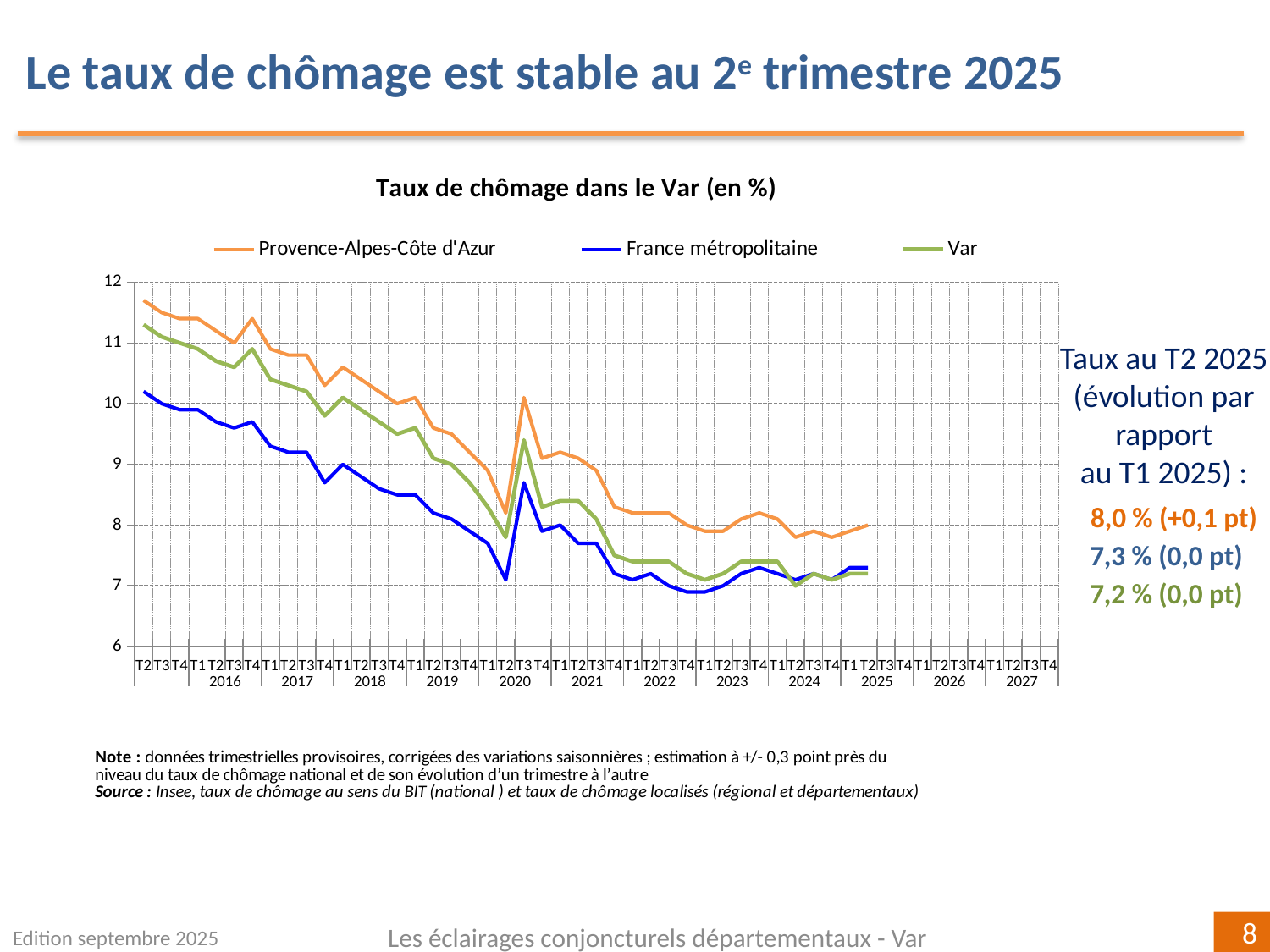
What is the unemployment rate for Provence-Alpes-Côte d'Azur at T2 2025? 8,0 % What is the title of the chart? Taux de chômage dans le Var (en %) Overall, does the Var line rise or fall between 2016 and 2025? fall What kind of chart is shown on the slide? line chart Is the value for France métropolitaine at T2 2020 greater or less than 8? less What is the unemployment rate for France métropolitaine at T2 2025? 7,3 % Which series has the highest value at T2 2025? Provence-Alpes-Côte d'Azur At T2 2025, which is higher: the rate for Provence-Alpes-Côte d'Azur or for France métropolitaine? Provence-Alpes-Côte d'Azur What is the unemployment rate for Var at T2 2025? 7,2 % Is the value for Provence-Alpes-Côte d'Azur at the first point on the x axis (T2 2015) greater or less than 11? greater How many series does the legend list? 3 At T2 2025, what is the difference between the Provence-Alpes-Côte d'Azur rate and the Var rate, in points? 0,8 pt